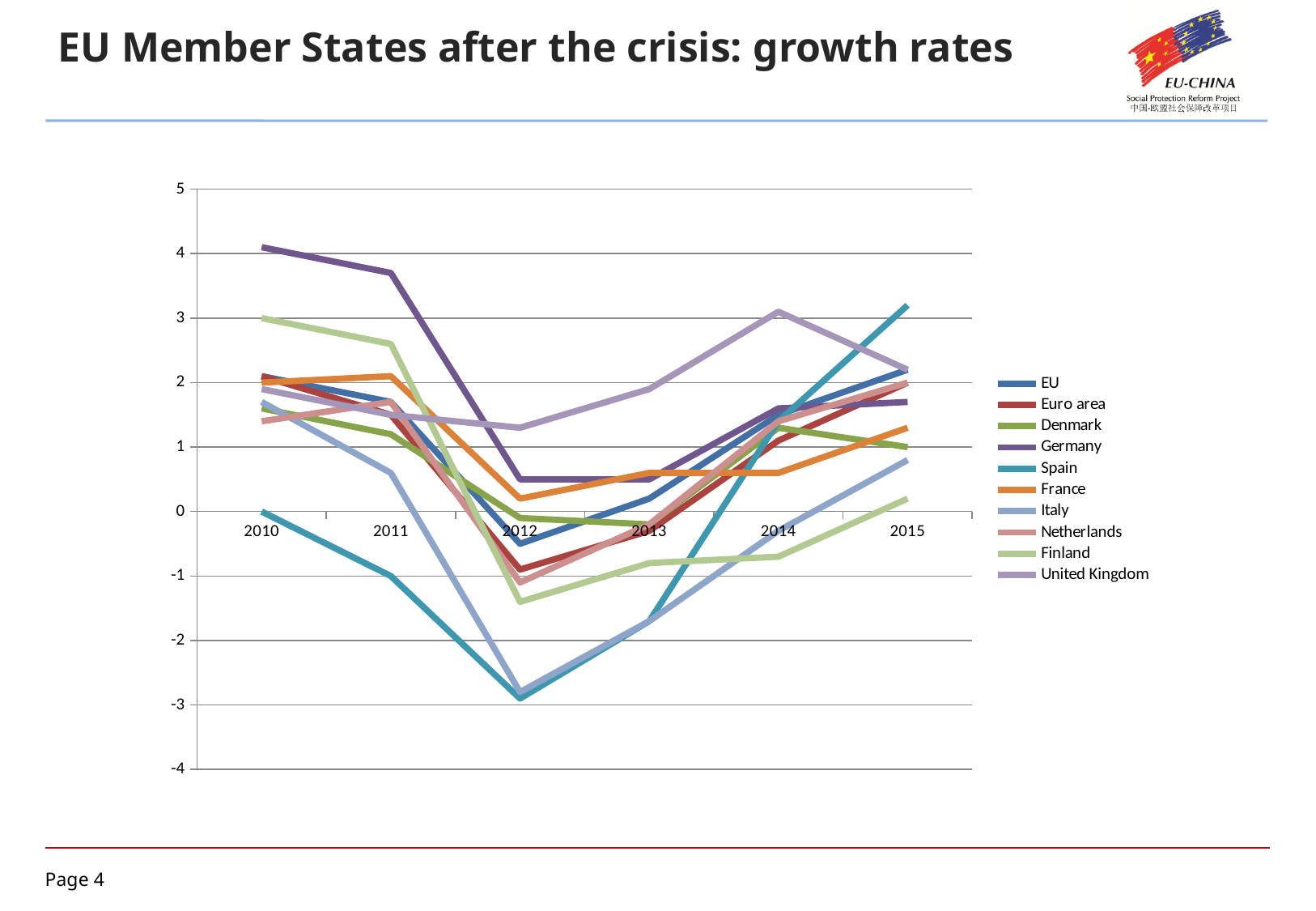
Which series has the highest growth rate in 2015? Spain Does the Spain line rise or fall from 2012 to 2015? rise Is the value for Finland in 2012 greater or less than -1? less Which series has the lowest growth rate in 2015? Finland Which series has the highest growth rate in 2010? Germany Is the value for the United Kingdom in 2014 greater or less than 2? greater Is the value for Spain in 2012 greater or less than -2? less What kind of chart is shown on the slide? line chart How many years are shown along the x axis? 6 How many series does the legend list? 10 Which series has the lowest growth rate in 2010? Spain